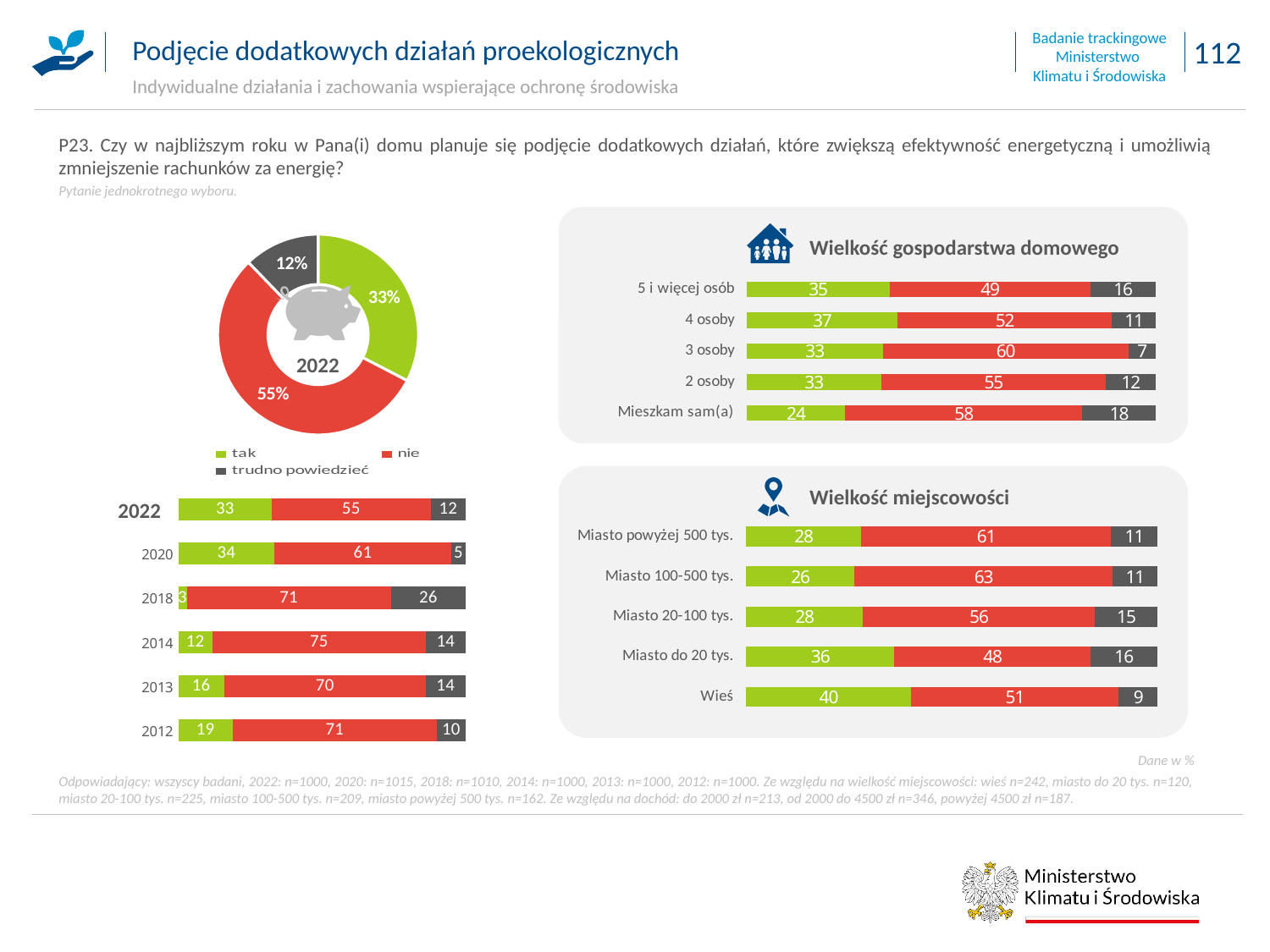
What type of chart is the "Wielkość miejscowości" chart? Stacked bar chart In the stacked bar chart by year (left, bottom), how many years are shown? 6 In the stacked bar chart by year (left, bottom), which year has the lowest "tak" value? 2018 How many series does the legend of the donut chart list? 3 In the "Wielkość gospodarstwa domowego" chart, what is the "nie" value for "3 osoby"? 60 In the stacked bar chart by year (left, bottom), what is the "nie" value for 2014? 75 In the "Wielkość miejscowości" chart, what is the difference between the "tak" values for "Wieś" and "Miasto 100-500 tys."? 14 In the stacked bar chart by year (left, bottom), which year has the highest "tak" value? 2020 In the "Wielkość gospodarstwa domowego" chart, which category has the lowest "tak" value? Mieszkam sam(a) In the donut chart for 2022, what share of respondents answered "tak"? 33% In the donut chart for 2022, what share of respondents answered "nie"? 55% In the "Wielkość miejscowości" chart, which category has the highest "tak" value? Wieś